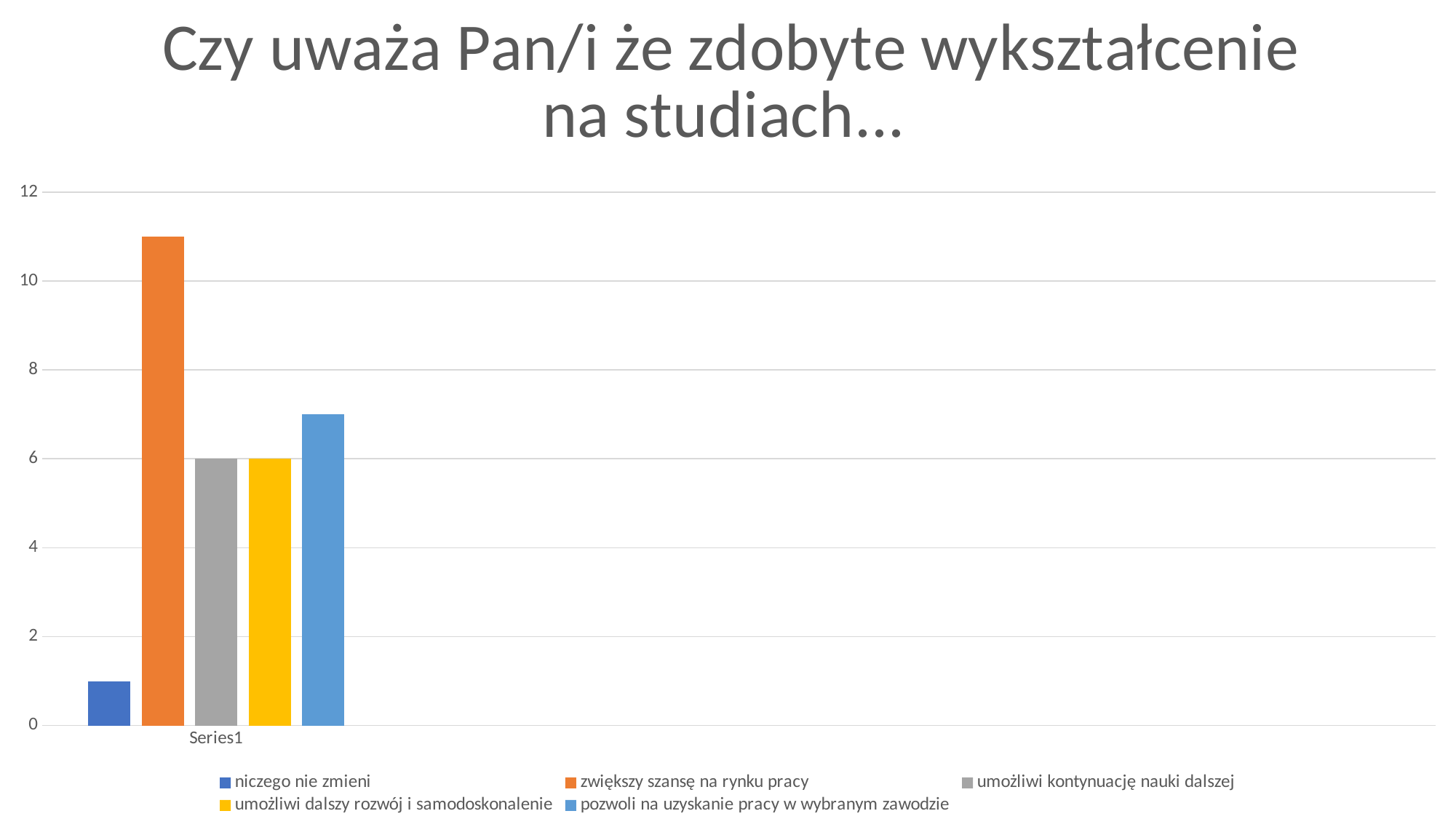
Is the value for 'niczego nie zmieni' greater or less than 2? less How many series does the legend list? 5 Which is larger: the value for 'pozwoli na uzyskanie pracy w wybranym zawodzie' or the value for 'umożliwi kontynuację nauki dalszej'? pozwoli na uzyskanie pracy w wybranym zawodzie Is the value for 'zwiększy szansę na rynku pracy' greater or less than 10? greater Which series has the highest bar? zwiększy szansę na rynku pracy What is the category label shown on the x axis? Series1 Is the value for 'pozwoli na uzyskanie pracy w wybranym zawodzie' greater or less than 8? less What is the value for 'umożliwi dalszy rozwój i samodoskonalenie'? 6 What colour is the bar for 'zwiększy szansę na rynku pracy'? orange What kind of chart is shown on the slide? bar chart What is the value for 'umożliwi kontynuację nauki dalszej'? 6 Which series has the lowest bar? niczego nie zmieni